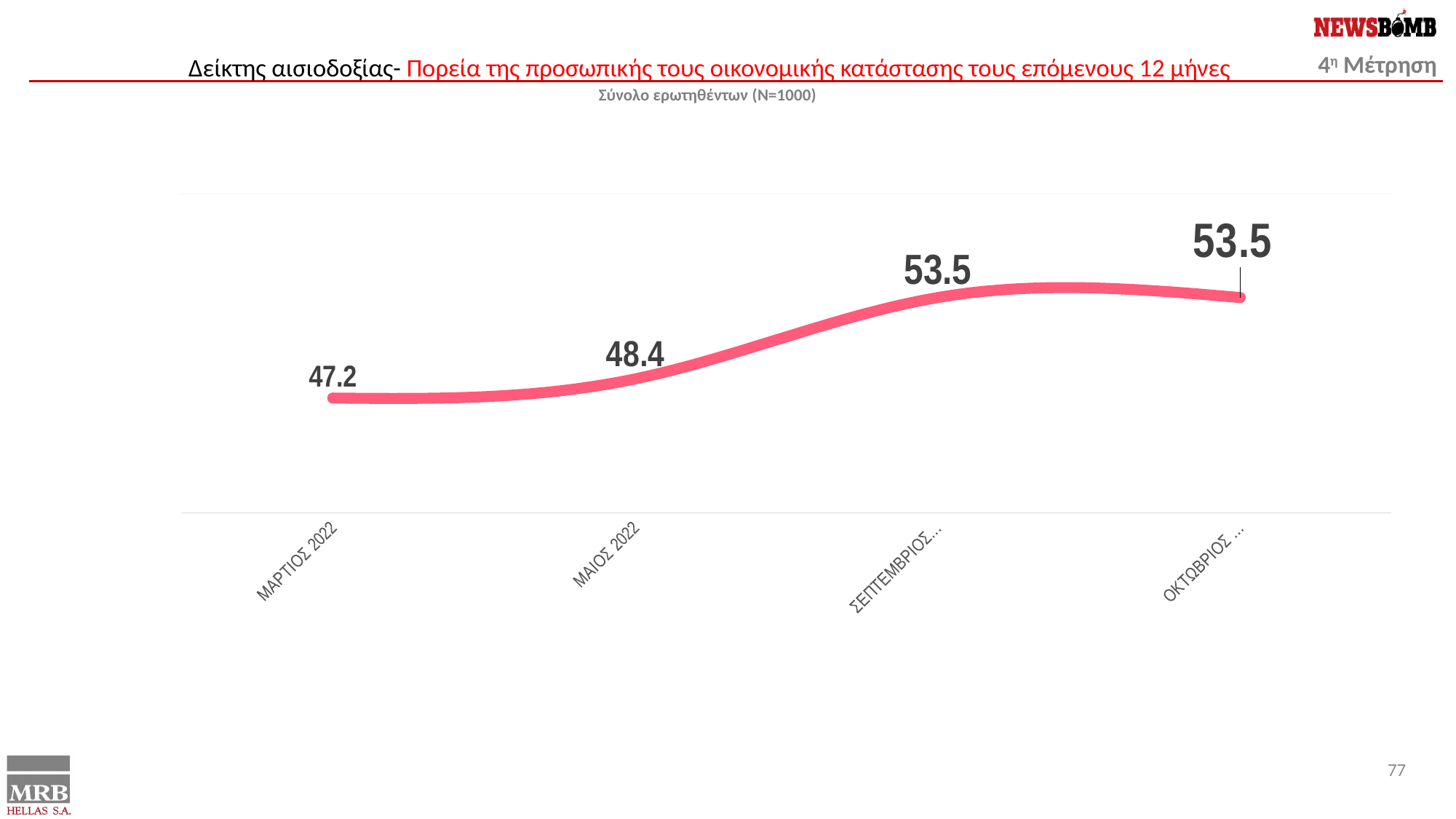
What is the difference between the values for ΣΕΠΤΕΜΒΡΙΟΣ and ΜΑΡΤΙΟΣ 2022? 6.3 What is the value for ΜΑΡΤΙΟΣ 2022? 47.2 How many data points are plotted on the chart? 4 What is the sample size (N) stated under the chart title? N=1000 Do the values rise or fall from ΜΑΡΤΙΟΣ 2022 to ΣΕΠΤΕΜΒΡΙΟΣ? Rise What is the value for ΣΕΠΤΕΜΒΡΙΟΣ? 53.5 Which has the larger value, ΜΑΙΟΣ 2022 or ΜΑΡΤΙΟΣ 2022? ΜΑΙΟΣ 2022 What is the difference between the values for ΜΑΙΟΣ 2022 and ΜΑΡΤΙΟΣ 2022? 1.2 What is the value for ΟΚΤΩΒΡΙΟΣ? 53.5 What kind of chart is shown on the slide? Line chart Which point on the chart has the lowest value? ΜΑΡΤΙΟΣ 2022 What is the value for ΜΑΙΟΣ 2022? 48.4